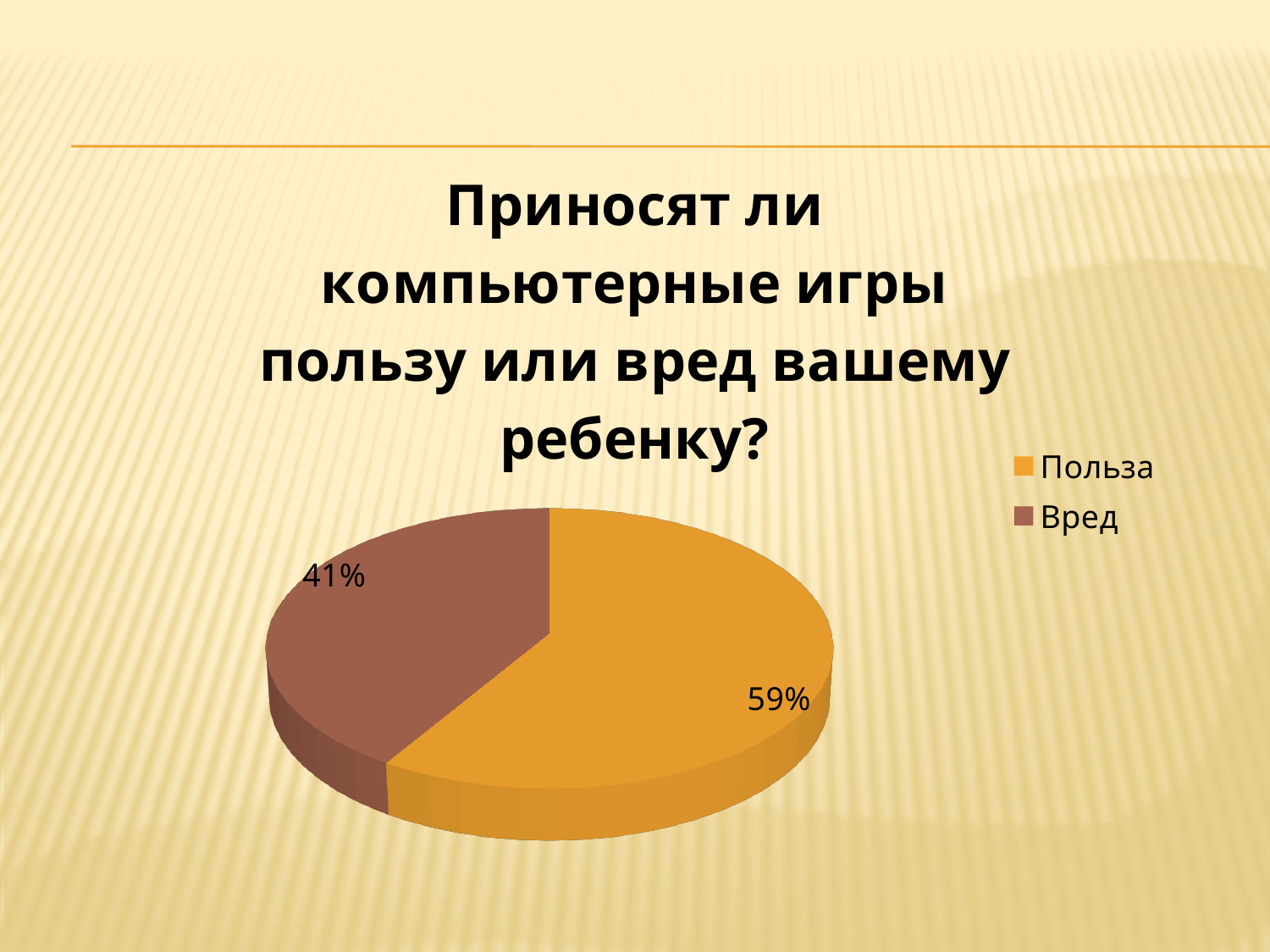
What percentage is shown for Вред? 41% What share of the pie does the Вред slice take? 41% Which slice is the largest? Польза What percentage is shown for Польза? 59% Which slice is the smallest? Вред What is the difference between the Польза and Вред shares? 18% How many slices does the pie chart have? 2 Which is larger, Польза or Вред? Польза What kind of chart is shown on the slide? pie chart How many entries does the legend list? 2 What is the title of the chart? Приносят ли компьютерные игры пользу или вред вашему ребенку? What colour is the Польза slice? orange